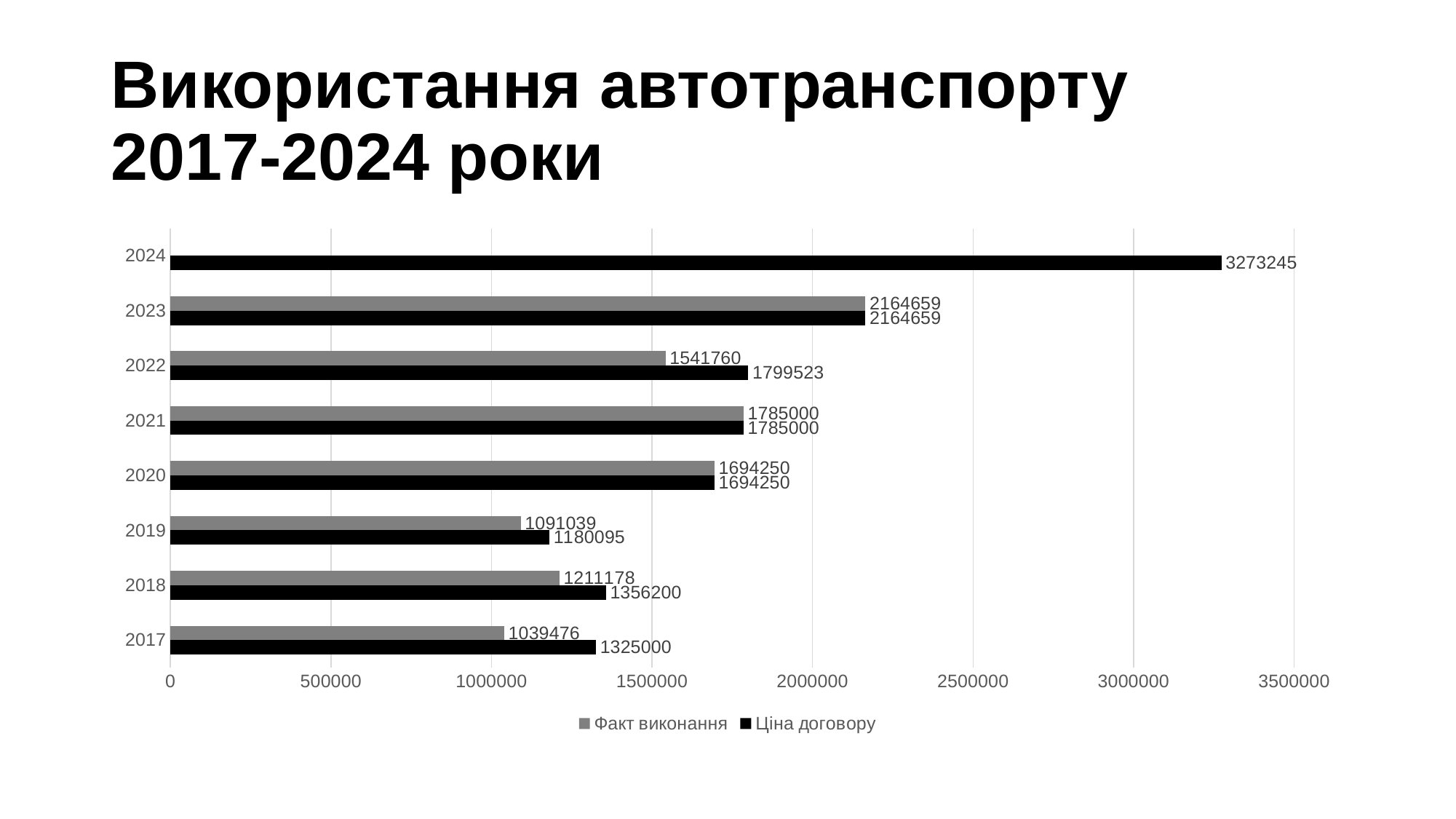
How many years are shown on the chart? 8 What is the difference between Ціна договору and Факт виконання for 2017? 285524 Which year has the highest Ціна договору? 2024 What is the value of Ціна договору for 2024? 3273245 How many series does the legend list? 2 Which year has the lowest Ціна договору? 2019 What is the difference between Ціна договору and Факт виконання for 2022? 257763 What is the value of Факт виконання for 2022? 1541760 Which year has the lowest Факт виконання? 2017 What is the value of Ціна договору for 2018? 1356200 What type of chart is shown on the slide? Bar chart Which is larger for 2019: Факт виконання or Ціна договору? Ціна договору